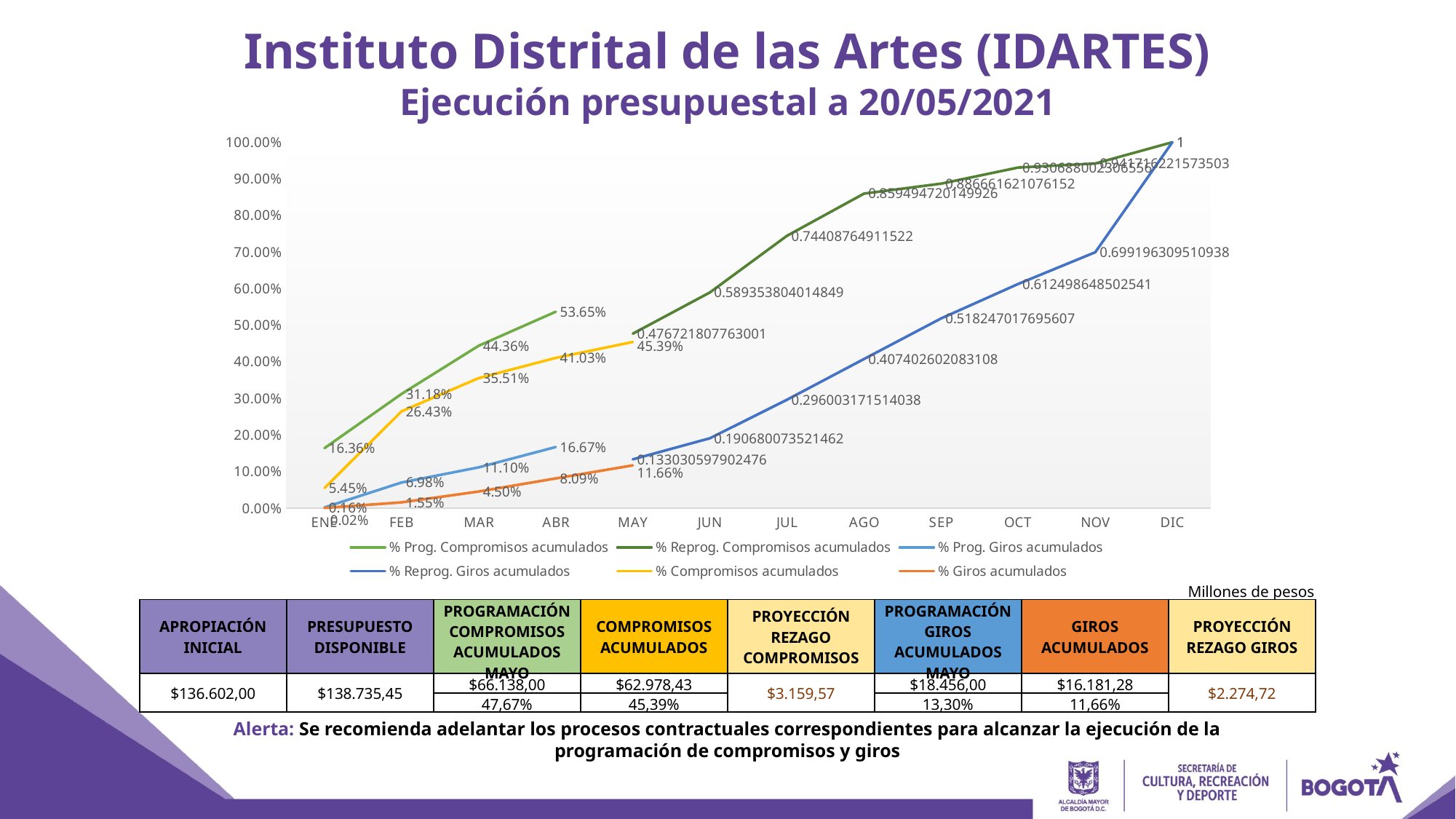
What is the title of the slide containing the chart? Instituto Distrital de las Artes (IDARTES) Ejecución presupuestal a 20/05/2021 Is the value for % Reprog. Giros acumulados in OCT greater or less than 50.00%? greater What is the value of % Prog. Giros acumulados in ABR? 16.67% What kind of chart is shown on the slide? line chart In MAR, which is larger: % Prog. Compromisos acumulados or % Compromisos acumulados? % Prog. Compromisos acumulados What is the value of % Prog. Compromisos acumulados in ABR? 53.65% What is the difference between % Prog. Compromisos acumulados and % Compromisos acumulados in ABR? 12.62 percentage points What is the value of % Giros acumulados in MAY? 11.66% How many months are shown along the x axis of the chart? 12 What is the value of % Compromisos acumulados in MAY? 45.39% How many series does the chart legend list? 6 Does the % Reprog. Compromisos acumulados line rise or fall from MAY to DIC? rise